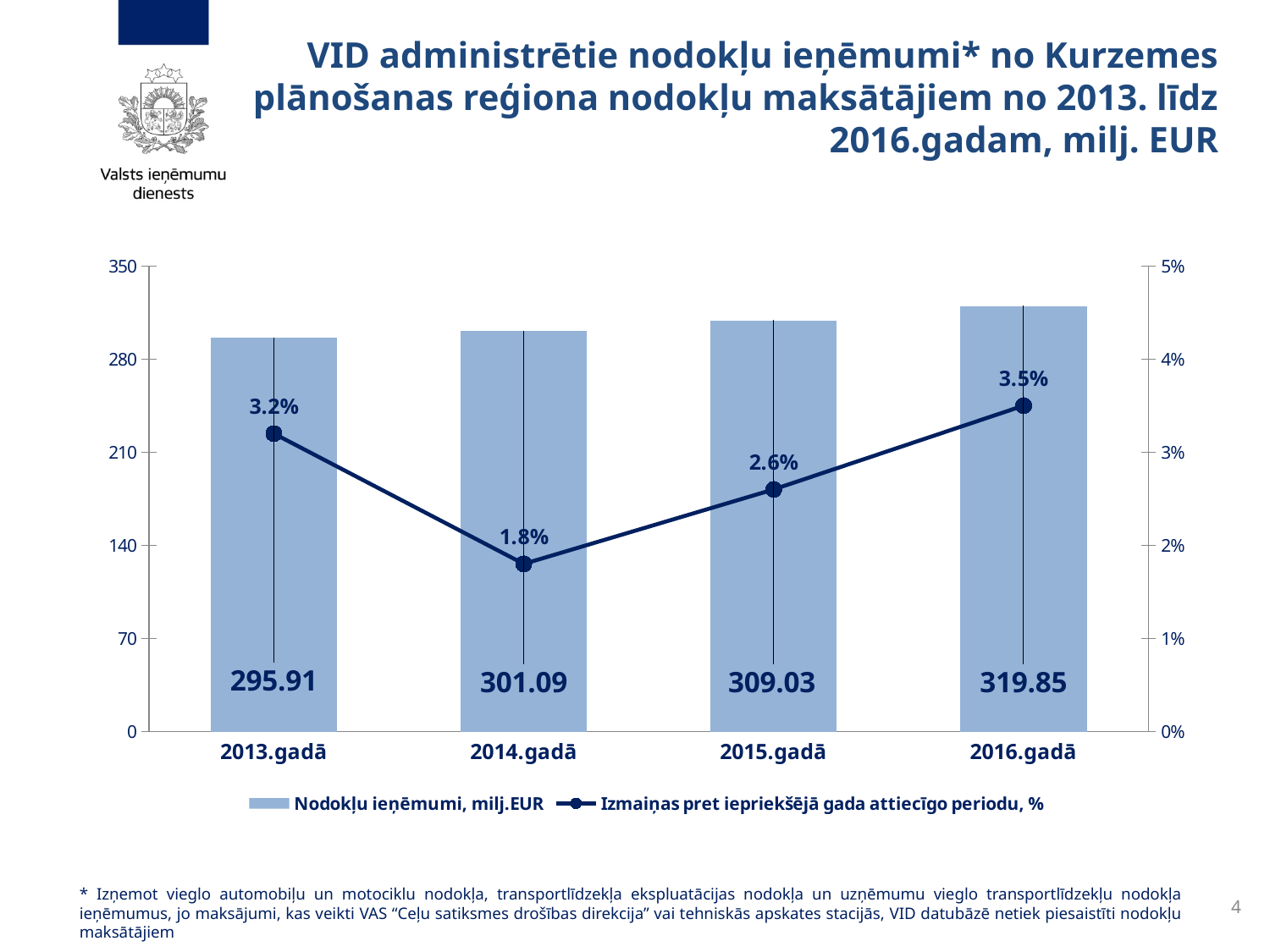
What is the value of Nodokļu ieņēmumi, milj.EUR for 2016.gadā? 319.85 What is the label of the right-hand vertical axis' top tick? 5% What is the value of Nodokļu ieņēmumi, milj.EUR for 2014.gadā? 301.09 What is the value of Izmaiņas pret iepriekšējā gada attiecīgo periodu, % for 2015.gadā? 2.6% Is the Nodokļu ieņēmumi, milj.EUR value for 2013.gadā greater or less than 280? greater What is the difference in Nodokļu ieņēmumi, milj.EUR between 2016.gadā and 2013.gadā? 23.94 Which year has the highest Nodokļu ieņēmumi, milj.EUR? 2016.gadā How many years are shown on the x axis? 4 How many series does the legend list? 2 Which year has the lowest Izmaiņas pret iepriekšējā gada attiecīgo periodu, %? 2014.gadā Which is larger: the Izmaiņas pret iepriekšējā gada attiecīgo periodu, % for 2013.gadā or for 2016.gadā? 2016.gadā Do the Nodokļu ieņēmumi, milj.EUR values rise or fall from 2013.gadā to 2016.gadā? rise